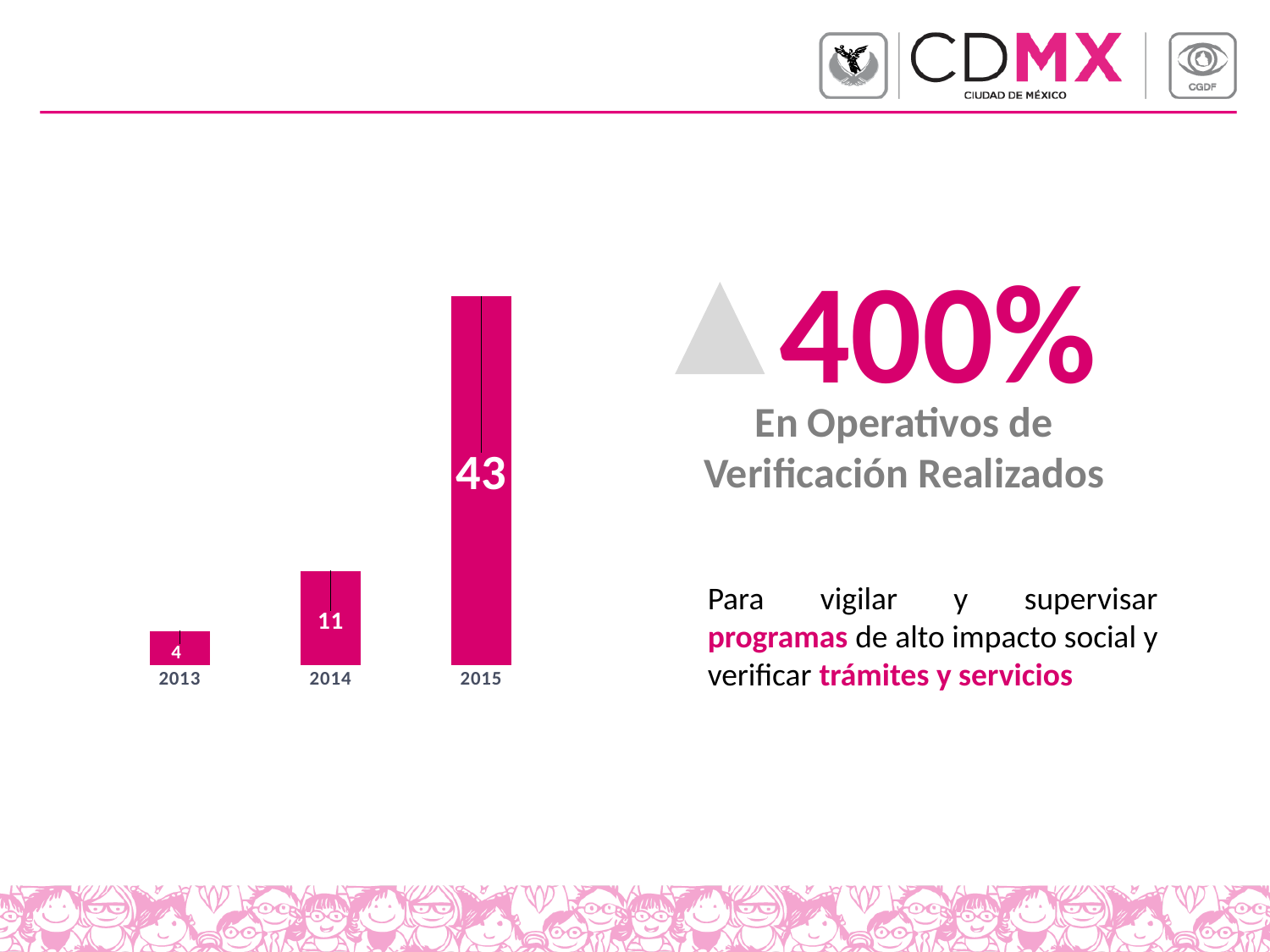
Which year has the lowest value? 2013 Which year has the highest value? 2015 What is the value for 2013? 4 Do the values rise or fall from 2013 to 2015? rise What percentage increase is stated next to the chart? 400% How many years are shown on the chart? 3 What kind of chart is shown? bar chart Which is larger, the value for 2014 or the value for 2013? 2014 What is the value for 2015? 43 What is the difference between the values for 2015 and 2014? 32 What is the value for 2014? 11 What is the difference between the values for 2014 and 2013? 7